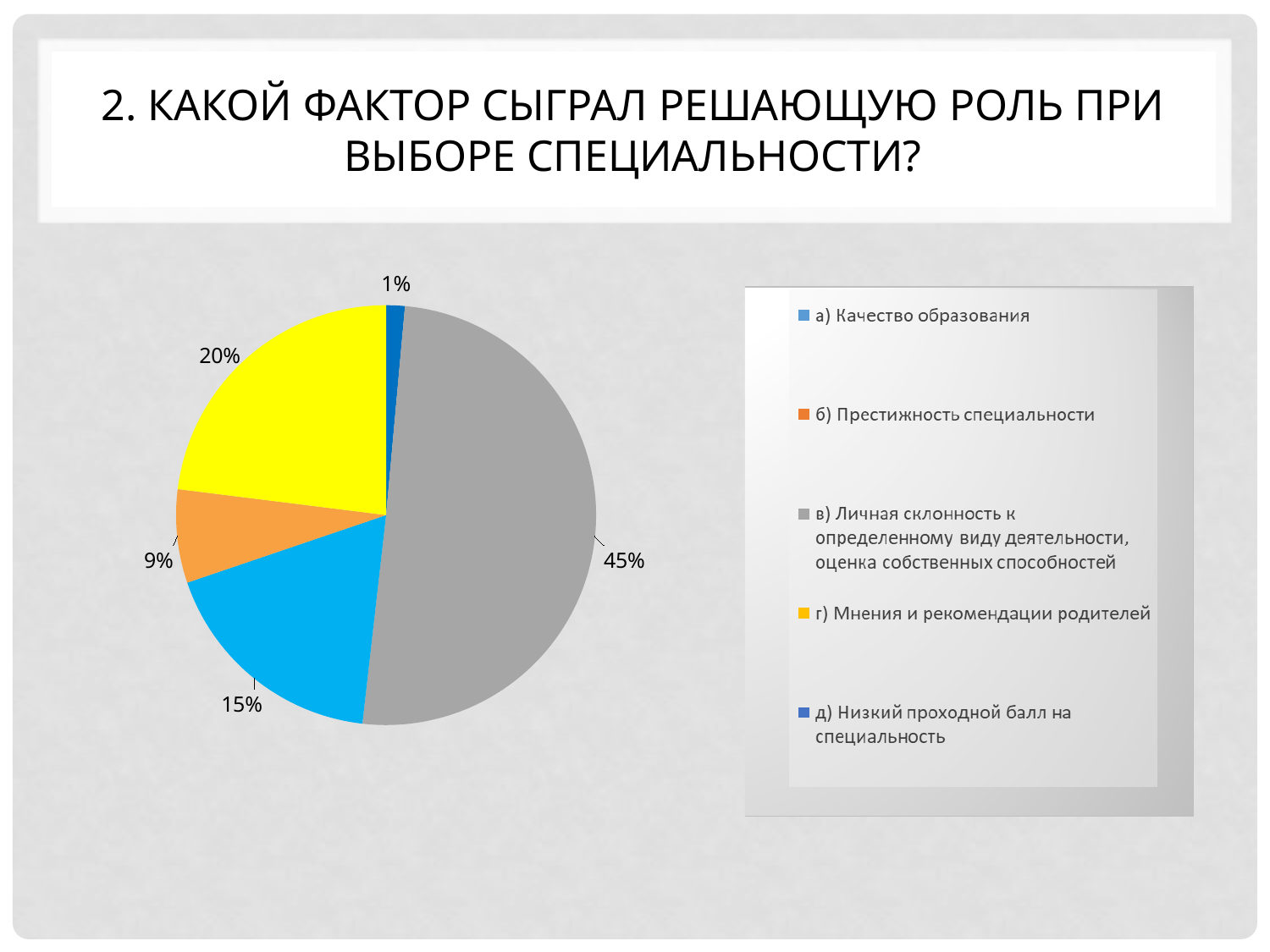
Which is larger: the share for "а) Качество образования" or the share for "б) Престижность специальности"? а) Качество образования What is the difference between the shares for "г) Мнения и рекомендации родителей" and "а) Качество образования"? 5% What share of the pie does "г) Мнения и рекомендации родителей" have? 20% What share of the pie does "д) Низкий проходной балл на специальность" have? 1% Which category has the largest slice of the pie? в) Личная склонность к определенному виду деятельности, оценка собственных способностей What colour is the slice for "г) Мнения и рекомендации родителей"? Yellow What share of the pie does "в) Личная склонность к определенному виду деятельности, оценка собственных способностей" have? 45% What kind of chart is shown on the slide? Pie chart How many categories does the pie chart have? 5 What share of the pie does "б) Престижность специальности" have? 9% What share of the pie does "а) Качество образования" have? 15% Which category has the smallest slice of the pie? д) Низкий проходной балл на специальность